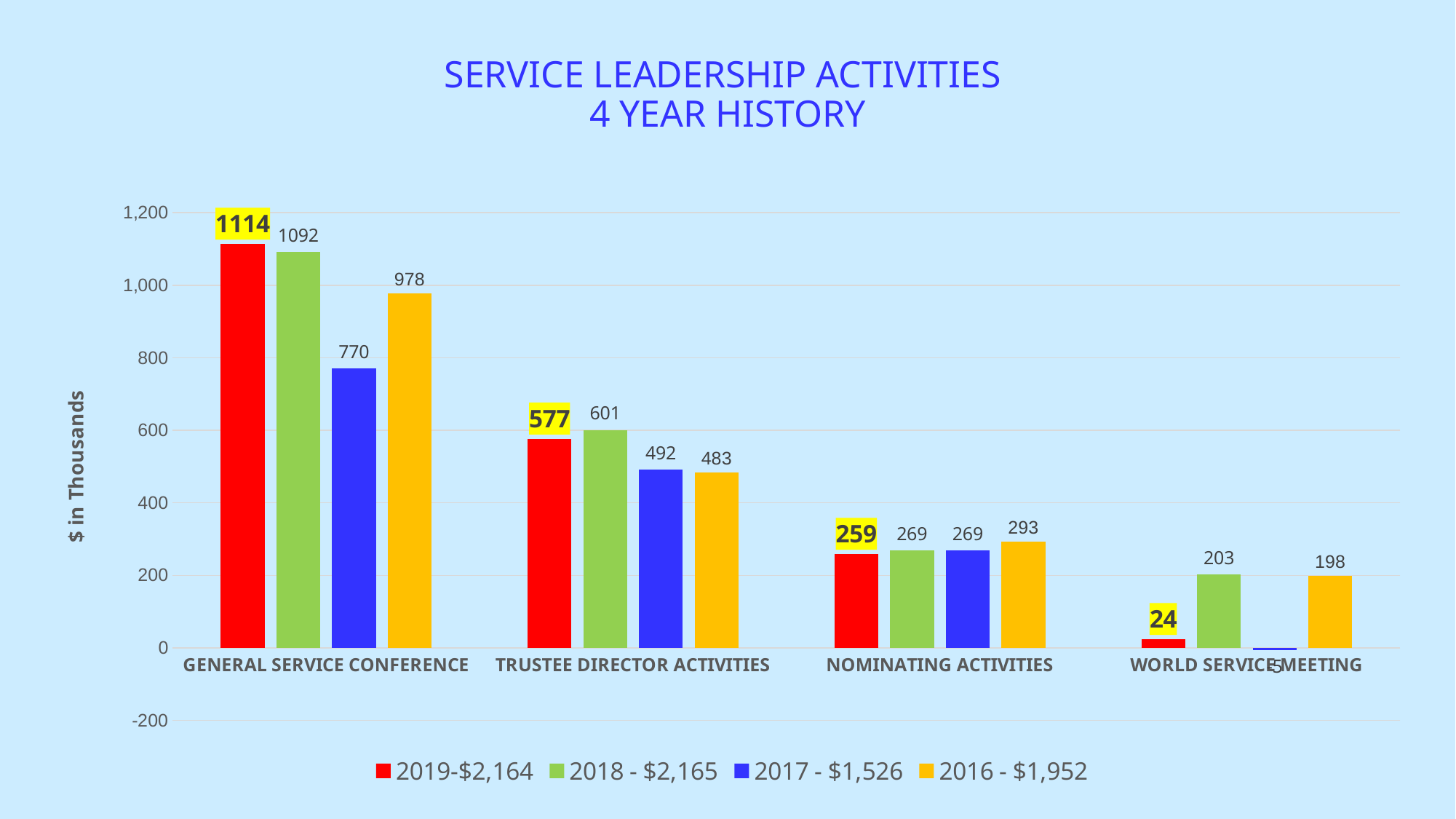
What is the value for General Service Conference in the 2019 series? 1114 Which category has the highest value in the 2017 series? General Service Conference Is the 2016 value for General Service Conference greater or less than 1,000? less What is the difference between the 2019 and 2018 values for General Service Conference? 22 What is the value for World Service Meeting in the 2019 series? 24 How many series does the legend list? 4 How many categories are shown on the x axis? 4 What is the value for Trustee Director Activities in the 2018 series? 601 Which is larger for Trustee Director Activities: the 2017 value or the 2016 value? 2017 What is the value for Nominating Activities in the 2016 series? 293 Which category has the lowest value in the 2018 series? World Service Meeting What kind of chart is shown on the slide? bar chart